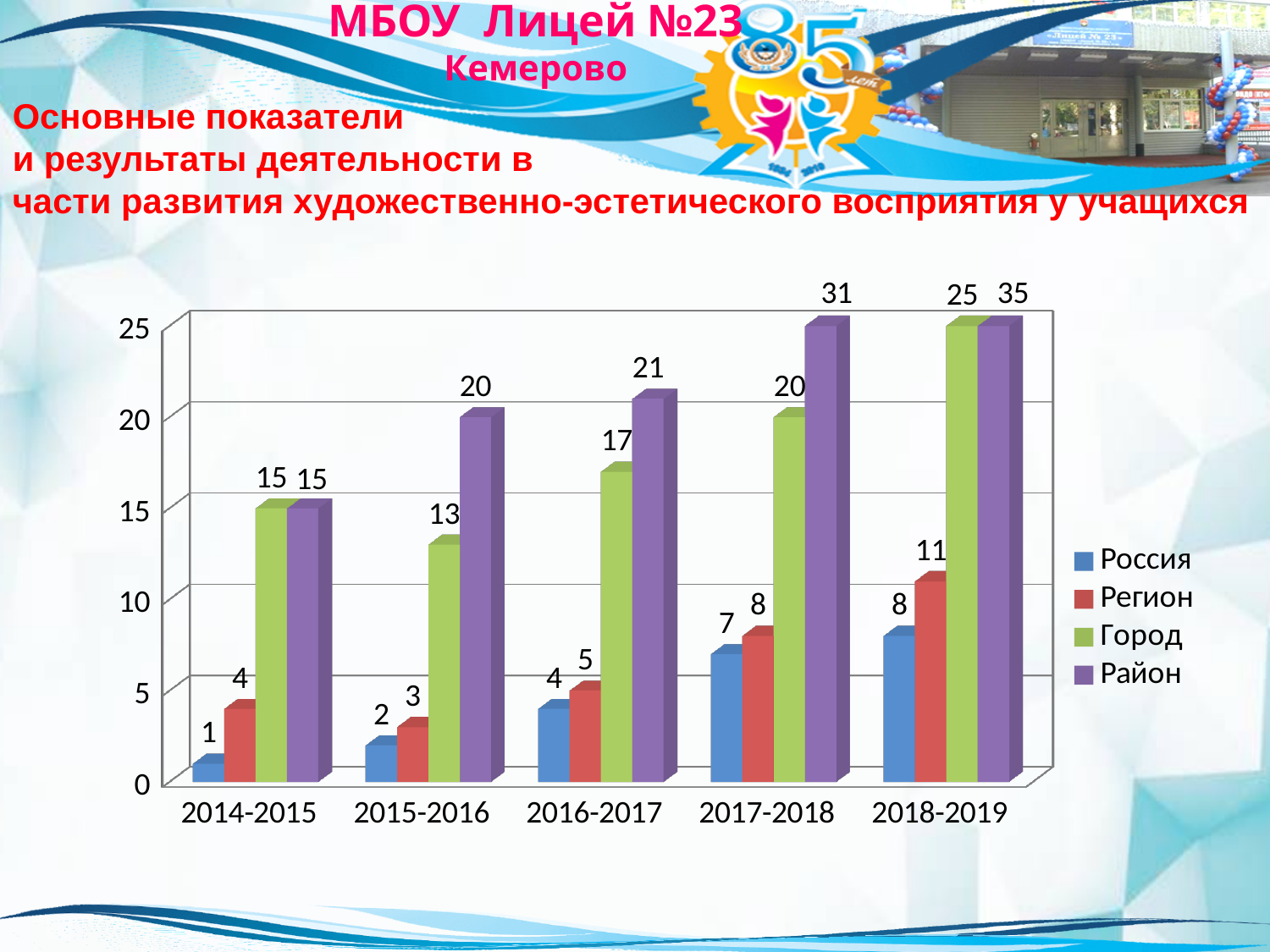
How many series does the legend list? 4 What is the difference between the Район and Город values in 2017-2018? 11 What kind of chart is shown on the slide? bar chart What is the value for Регион in 2017-2018? 8 How many school years are shown on the x axis? 5 What is the value for Россия in 2014-2015? 1 In which year is the value for Россия lowest? 2014-2015 Which is larger in 2015-2016: the value for Регион or the value for Город? Город Do the values for Город rise or fall from 2015-2016 to 2018-2019? rise What is the value for Город in 2016-2017? 17 What is the value for Район in 2018-2019? 35 In which year is the value for Район highest? 2018-2019